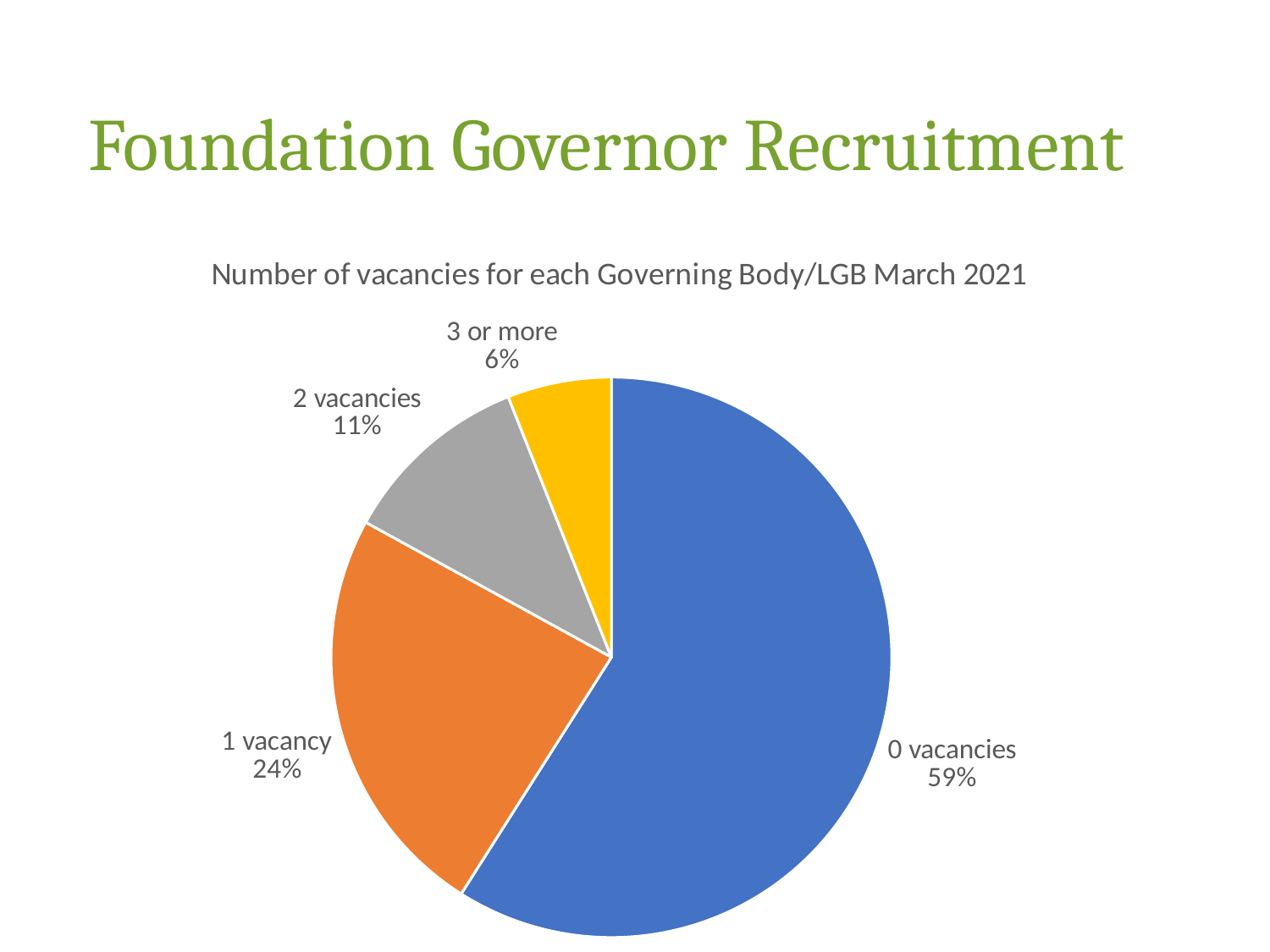
Which slice is larger, "2 vacancies" or "3 or more"? 2 vacancies What share of the pie is labelled "3 or more"? 6% How many slices does the pie chart have? 4 What kind of chart is shown on the slide? pie chart What share of the pie is labelled "0 vacancies"? 59% What share of the pie is labelled "1 vacancy"? 24% What colour is the "1 vacancy" slice? orange What is the title of the chart? Number of vacancies for each Governing Body/LGB March 2021 Which category has the smallest slice of the pie? 3 or more Which category has the largest slice of the pie? 0 vacancies What is the difference in percentage points between the "0 vacancies" slice and the "1 vacancy" slice? 35